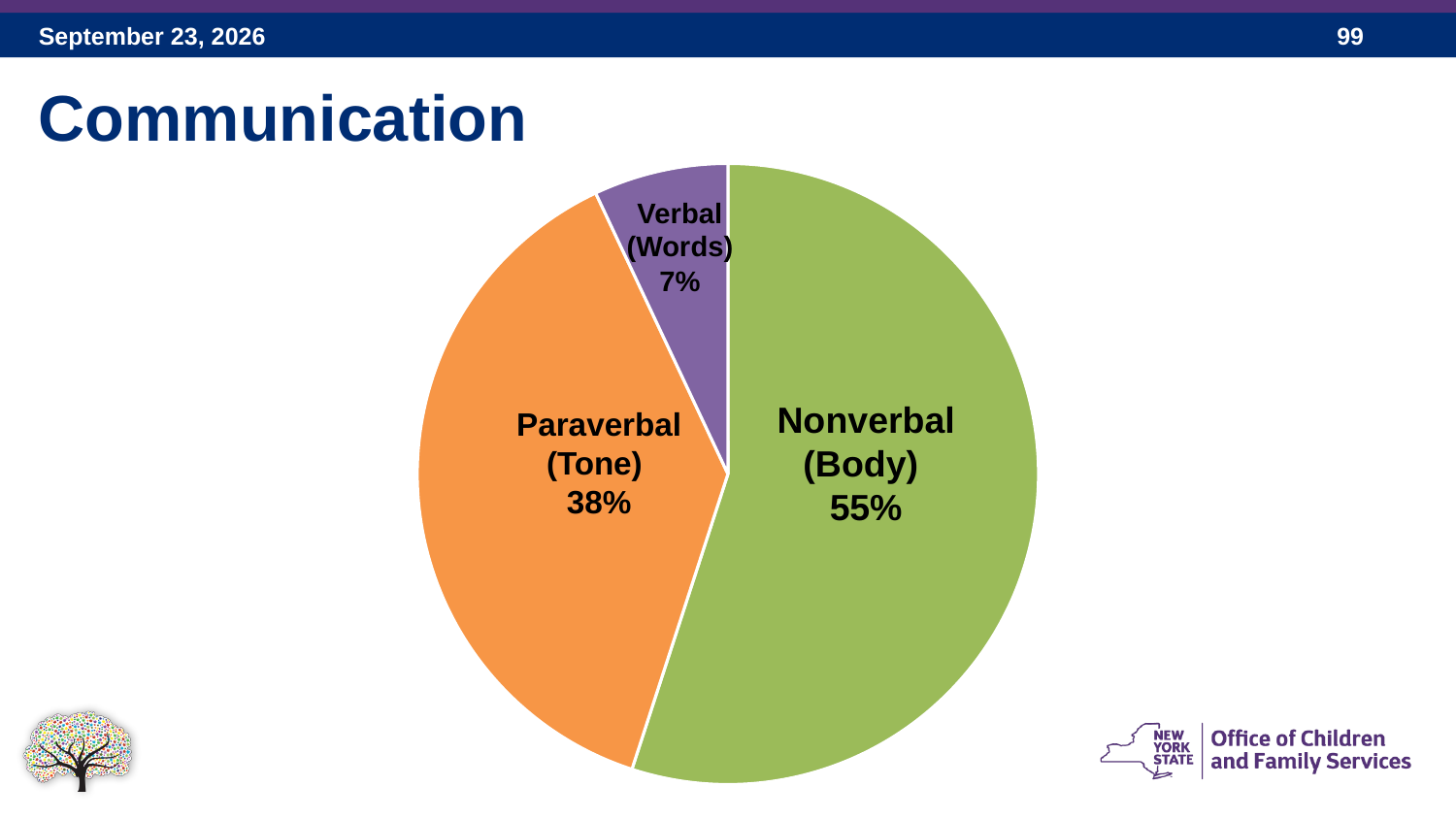
Which is larger, the Paraverbal (Tone) slice or the Verbal (Words) slice? Paraverbal (Tone) What percentage is shown for Verbal (Words)? 7% What percentage is shown for Paraverbal (Tone)? 38% What is the difference in percentage points between Nonverbal (Body) and Paraverbal (Tone)? 17 What colour is the Paraverbal (Tone) slice? orange Which slice of the pie is the smallest? Verbal (Words) What share of the pie does the Nonverbal (Body) slice represent? 55% Which slice of the pie is the largest? Nonverbal (Body) How many slices does the pie chart have? 3 What percentage is shown for Nonverbal (Body)? 55% What kind of chart is shown on the slide? pie chart What is the difference in percentage points between Paraverbal (Tone) and Verbal (Words)? 31